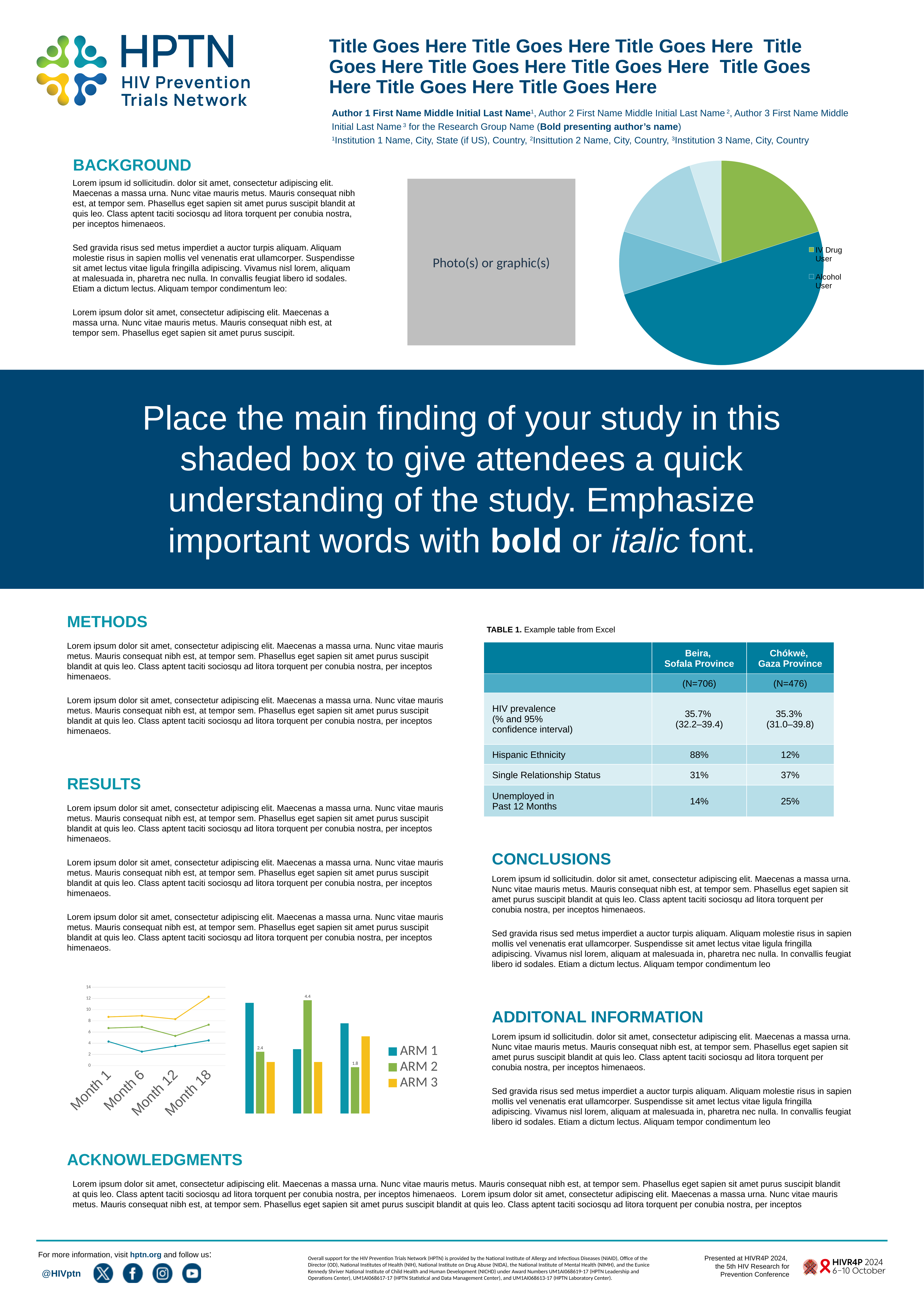
What kind of chart is the chart at the bottom left with Month 1 to Month 18 on the x axis? line chart In the pie chart at the top right, which legend entry is shown with a green marker? IV Drug User In the bar chart with the ARM legend, what is the labelled value of the ARM 2 bar in the second group of bars? 4.4 What kind of chart is the chart with the ARM 1, ARM 2 and ARM 3 legend? bar chart How many series does the legend of the bar chart with ARM 1, ARM 2 and ARM 3 list? 3 In the line chart at the bottom left, does the yellow line rise or fall from Month 12 to Month 18? rise What kind of chart is the chart at the top right of the slide, next to the 'Photo(s) or graphic(s)' placeholder? pie chart In the line chart at the bottom left, how many months are labelled on the x axis? 4 In the bar chart with the ARM legend, which group of bars has the lowest labelled ARM 2 value? the third group (1.8) In the line chart at the bottom left, is the value of the yellow line at Month 18 greater or less than 10? greater In the bar chart with the ARM legend, what is the difference between the labelled ARM 2 values in the second group (4.4) and the first group (2.4)? 2.0 In the line chart at the bottom left, is the value of the teal line at Month 6 greater or less than 4? less